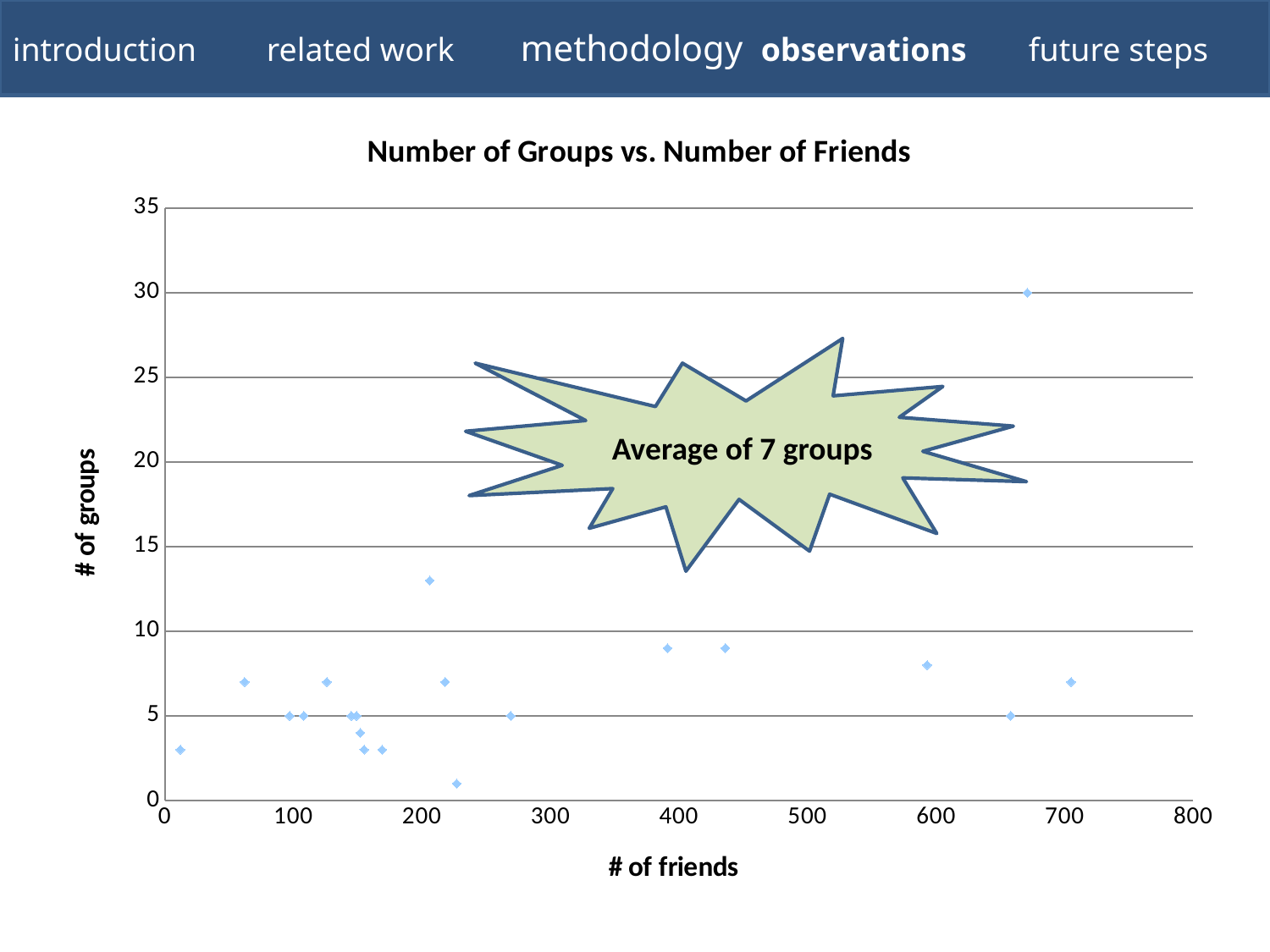
What is the maximum value shown on the vertical axis? 35 What is the highest # of groups reached by any point on the chart? 30 Is the highest # of groups on the chart greater or less than 25? greater What kind of chart is shown on the slide? scatter chart What is the label of the vertical axis? # of groups Is the # of groups for the highest point near 200 friends greater or less than 10? greater Which has more groups: the point at about 670 friends or the point at about 600 friends? the point at about 670 friends What is the title of the chart? Number of Groups vs. Number of Friends Is the # of groups for the point with the most friends (around 700) greater or less than 10? less